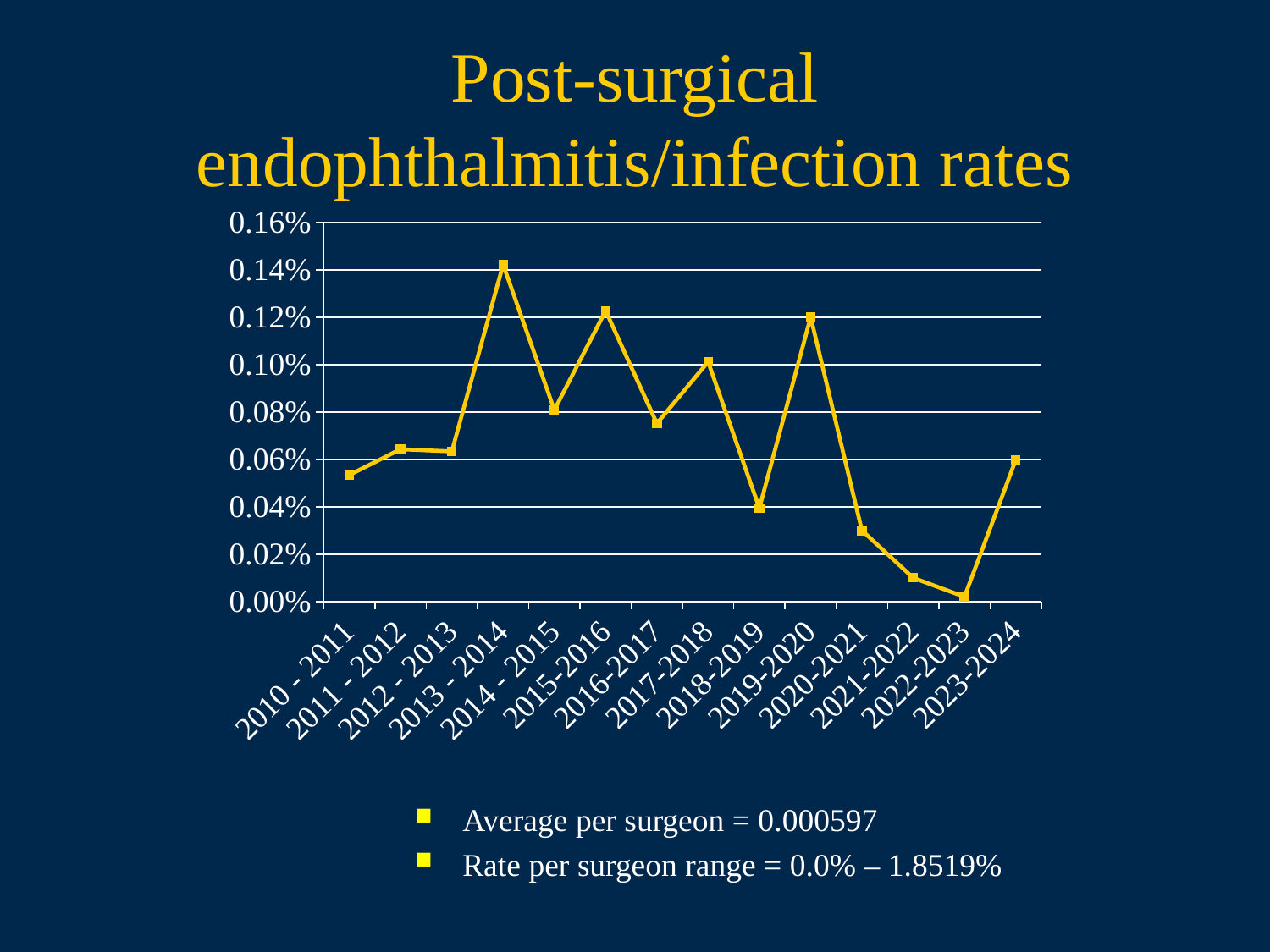
Is the value for 2021-2022 greater or less than 0.02%? less Which period has the highest post-surgical infection rate? 2013 - 2014 Which has the higher infection rate, 2013 - 2014 or 2019-2020? 2013 - 2014 Is the value for 2020-2021 greater or less than 0.04%? less Is the value for 2010 - 2011 greater or less than 0.06%? less Do the values rise or fall from 2019-2020 to 2022-2023? fall Which has the higher infection rate, 2020-2021 or 2023-2024? 2023-2024 How many time periods are plotted along the x axis? 14 What kind of chart is shown on the slide? line chart Which period has the lowest post-surgical infection rate? 2022-2023